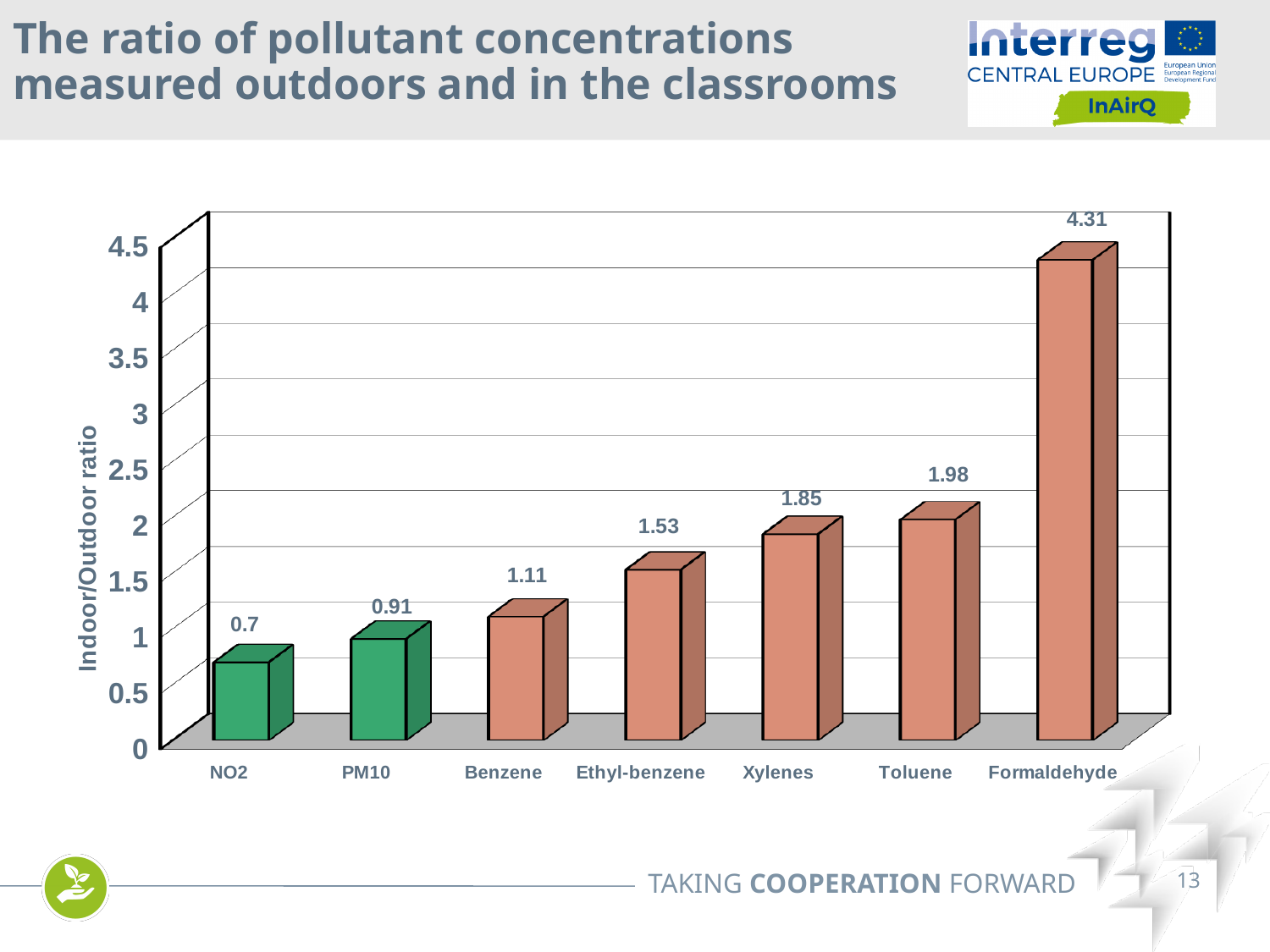
What kind of chart is shown on the slide? bar chart What is the Indoor/Outdoor ratio for NO2? 0.7 What is the Indoor/Outdoor ratio for Xylenes? 1.85 What is the difference between the Indoor/Outdoor ratio for Toluene and for Benzene? 0.87 What is the label of the vertical axis of the chart? Indoor/Outdoor ratio Which pollutant has the lowest Indoor/Outdoor ratio? NO2 How many pollutants are shown on the x axis of the chart? 7 Is the Indoor/Outdoor ratio for Toluene greater or less than 2? less Which has a larger Indoor/Outdoor ratio, PM10 or Ethyl-benzene? Ethyl-benzene Which pollutant has the highest Indoor/Outdoor ratio? Formaldehyde What is the Indoor/Outdoor ratio for Formaldehyde? 4.31 Do the Indoor/Outdoor ratios rise or fall from NO2 to Formaldehyde along the x axis? rise